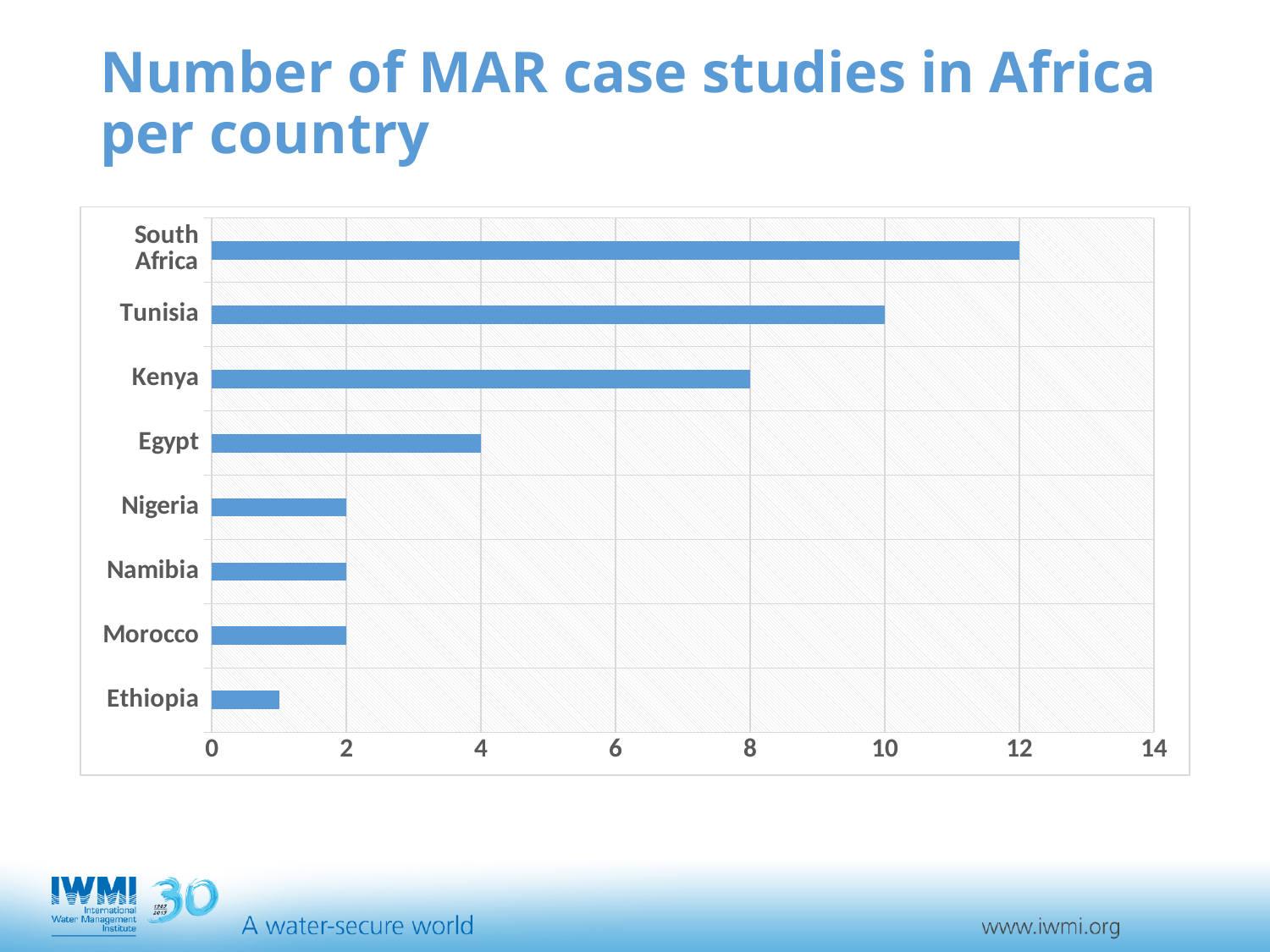
How many MAR case studies does South Africa have? 12 Which country has the lowest number of MAR case studies? Ethiopia What is the difference between the number of case studies for South Africa and Tunisia? 2 Which country has the highest number of MAR case studies? South Africa How many countries are shown in the chart? 8 Which has more MAR case studies, Kenya or Egypt? Kenya What is the title of the chart? Number of MAR case studies in Africa per country What type of chart is shown on the slide? Bar chart How many MAR case studies does Tunisia have? 10 Is the value for Ethiopia greater or less than 2? less How many MAR case studies does Egypt have? 4 How many MAR case studies does Kenya have? 8